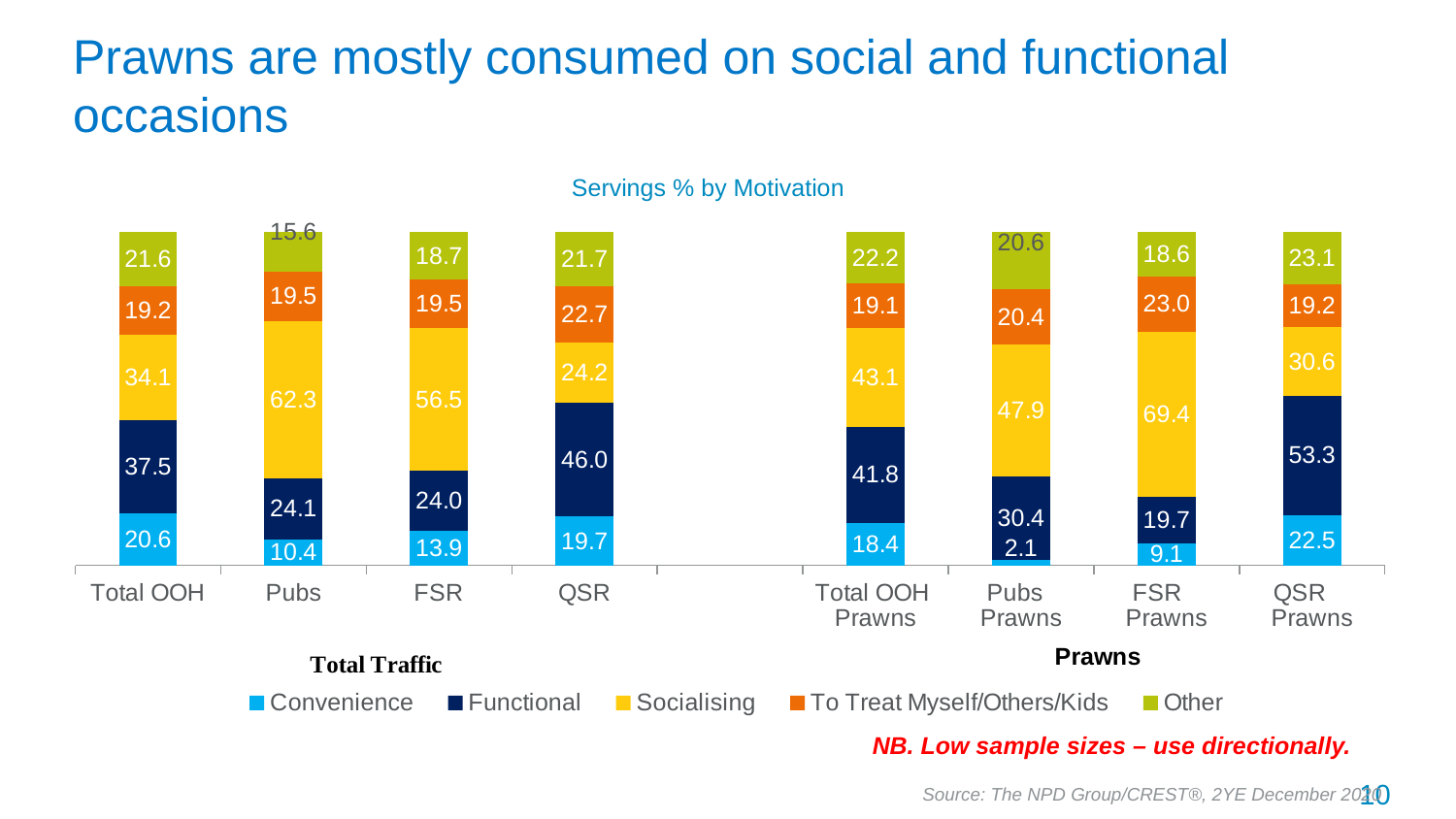
What is the 'To Treat Myself/Others/Kids' value for FSR Prawns? 23.0 How many series does the legend list? 5 What is the Functional value for QSR Prawns? 53.3 Which category has the highest Socialising value? FSR Prawns What is the title of the chart? Servings % by Motivation What is the Convenience value for Total OOH Prawns? 18.4 Which category has the lowest Convenience value? Pubs Prawns What is the Socialising value for Pubs? 62.3 How many categories are shown on the x axis? 8 What kind of chart is shown on the slide? Stacked bar chart Which is larger, the Functional value for QSR or the Functional value for Total OOH? QSR What is the difference between the Socialising values for FSR Prawns and FSR? 12.9